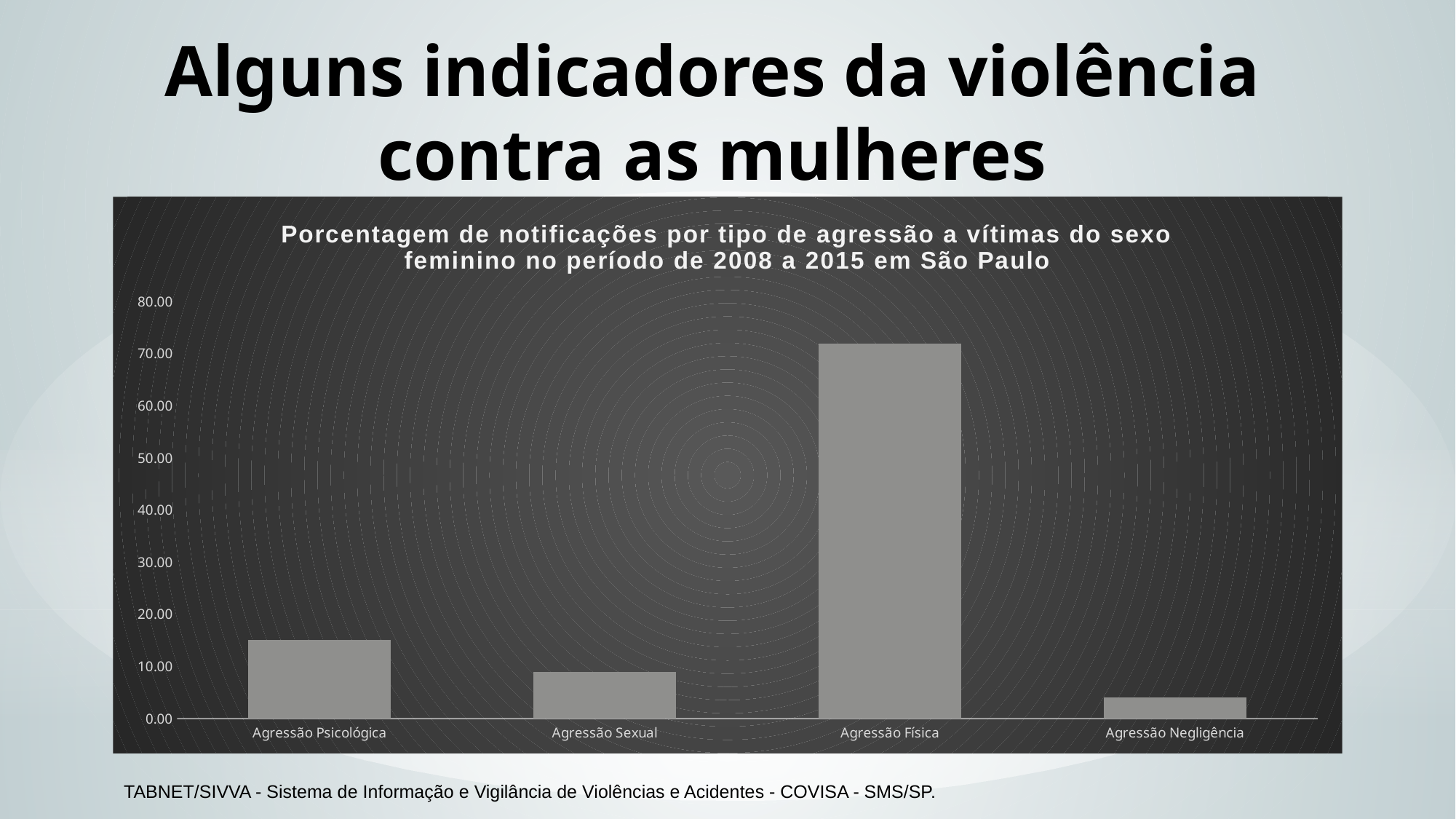
Is the value for Agressão Negligência greater or less than 10? less How many categories of aggression are shown on the x axis? 4 Which type of aggression has the highest percentage of notifications? Agressão Física Is the value for Agressão Sexual greater or less than 20? less Which is larger, the value for Agressão Psicológica or the value for Agressão Sexual? Agressão Psicológica What kind of chart is shown on the slide? bar chart What is the title of the chart? Porcentagem de notificações por tipo de agressão a vítimas do sexo feminino no período de 2008 a 2015 em São Paulo Is the value for Agressão Física greater or less than 60? greater Which type of aggression has the lowest percentage of notifications? Agressão Negligência Which is larger, the value for Agressão Sexual or the value for Agressão Negligência? Agressão Sexual